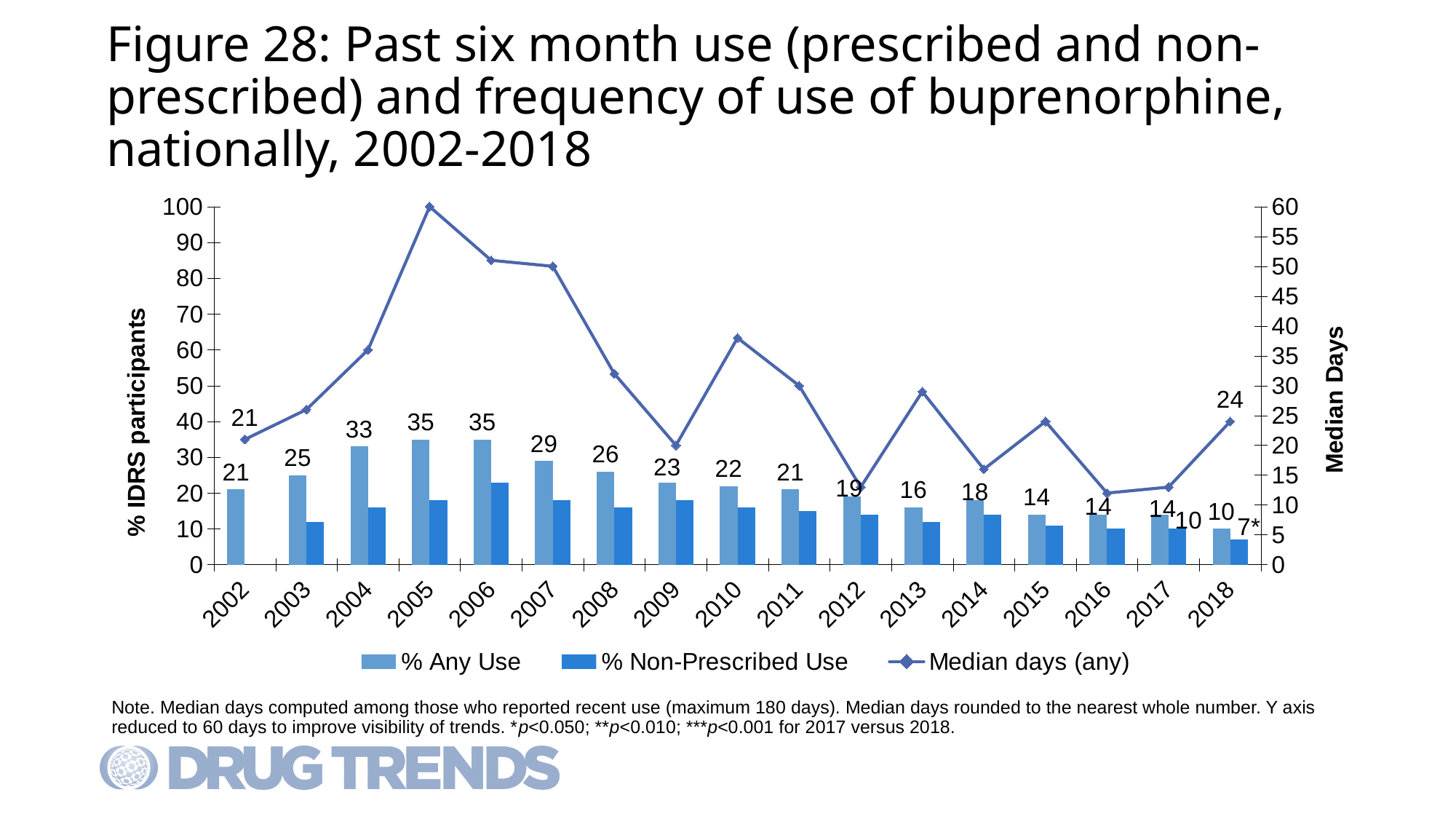
How many years are shown on the x axis? 17 Is the % Non-Prescribed Use value for 2003 greater or less than 20? less What kind of chart is shown on the slide? A combined bar and line chart Which year has the larger % Any Use value, 2007 or 2008? 2007 What is the Median days (any) value labelled for 2002? 21 What is the % Any Use value for 2005? 35 What is the % Any Use value for 2018? 10 What is the difference between the % Any Use values for 2004 and 2018? 23 Which year has the lowest % Any Use value? 2018 What is the Median days (any) value labelled for 2018? 24 Is the Median days (any) value for 2005 greater or less than 50? greater How many series does the legend list? 3